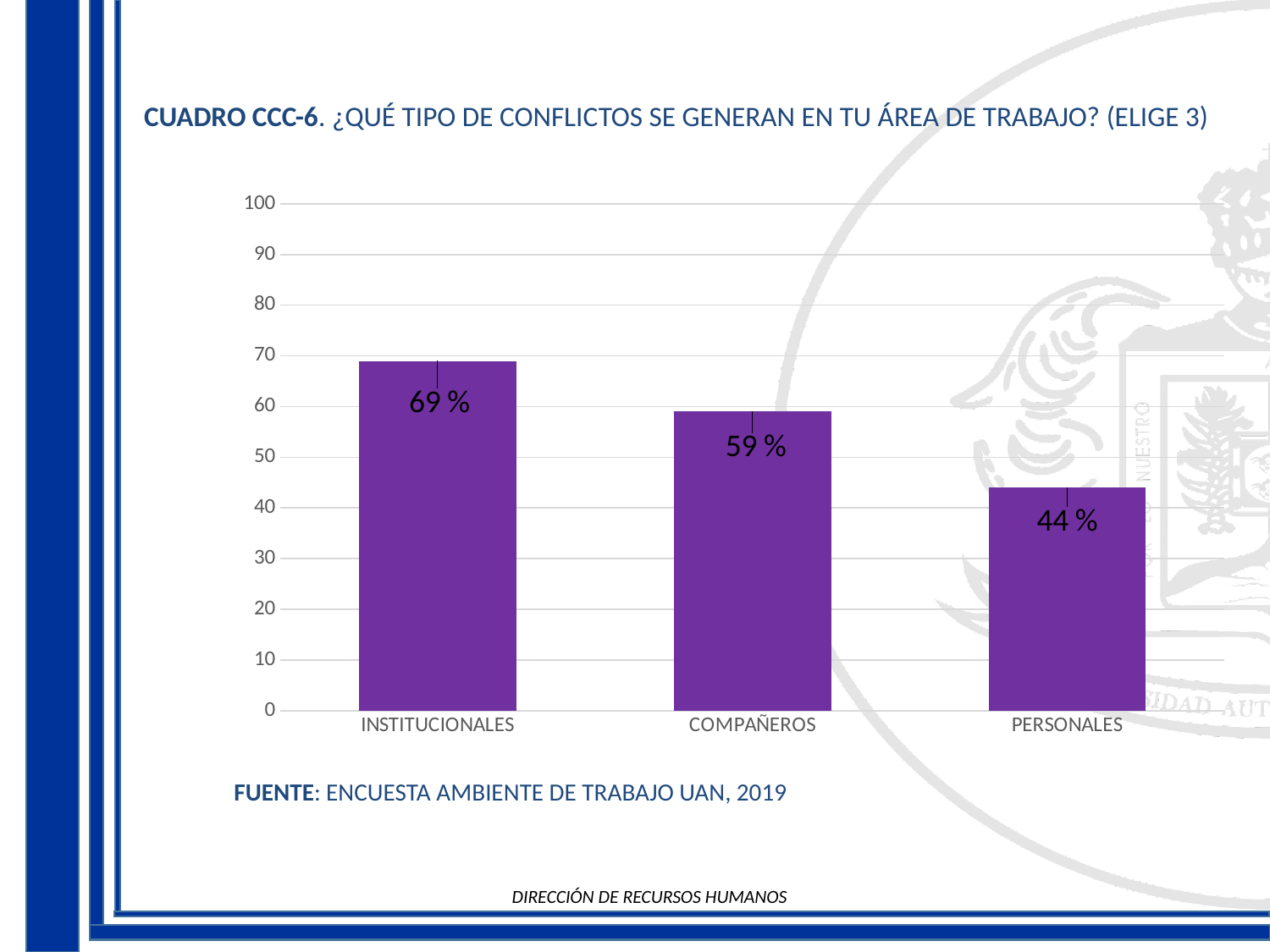
Do the values rise or fall from left to right along the x axis? fall Which category has the highest value? INSTITUCIONALES What is the value for COMPAÑEROS? 59 % What is the difference between the values for COMPAÑEROS and PERSONALES? 15 % What kind of chart is shown on the slide? bar chart What is the value for PERSONALES? 44 % Which category has the lowest value? PERSONALES Which is larger, the value for COMPAÑEROS or the value for PERSONALES? COMPAÑEROS What is the difference between the values for INSTITUCIONALES and PERSONALES? 25 % How many categories are shown on the x axis? 3 What is the value for INSTITUCIONALES? 69 % Is the value for PERSONALES greater or less than 50? less